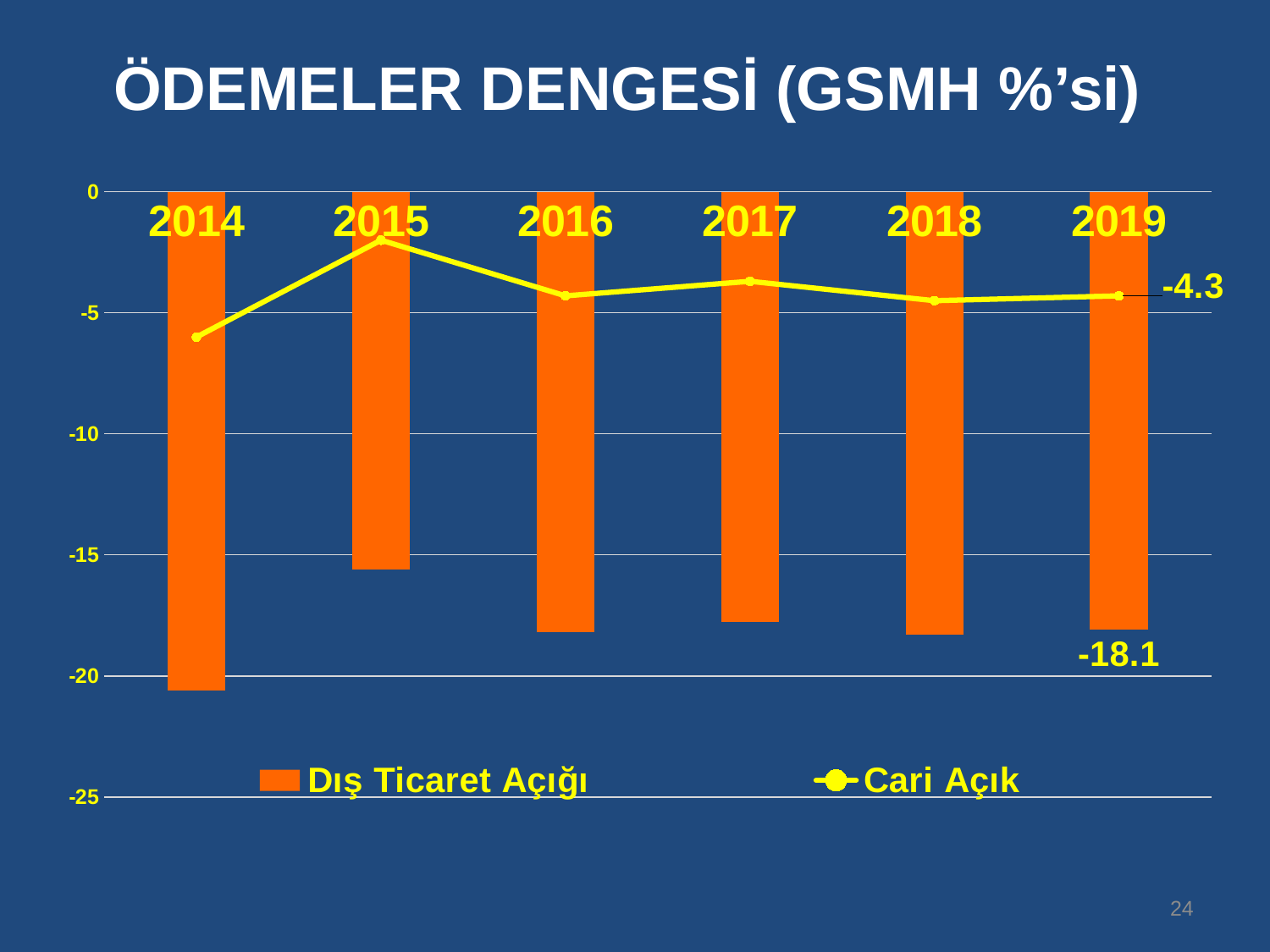
What is the value of Dış Ticaret Açığı for 2019? -18.1 What is the value of Cari Açık for 2019? -4.3 Which year has the highest Cari Açık value (closest to zero)? 2015 How many series does the legend list? 2 How many years are shown on the x axis of the chart? 6 Is the Dış Ticaret Açığı value for 2015 greater or less than -15? less What is the title of the chart? ÖDEMELER DENGESİ (GSMH %'si) Is the Cari Açık value for 2014 greater or less than -5? less Is the Cari Açık value for 2015 greater or less than -5? greater What kind of chart is shown on the slide? A combined bar and line chart Which year has the lowest (most negative) Dış Ticaret Açığı value? 2014